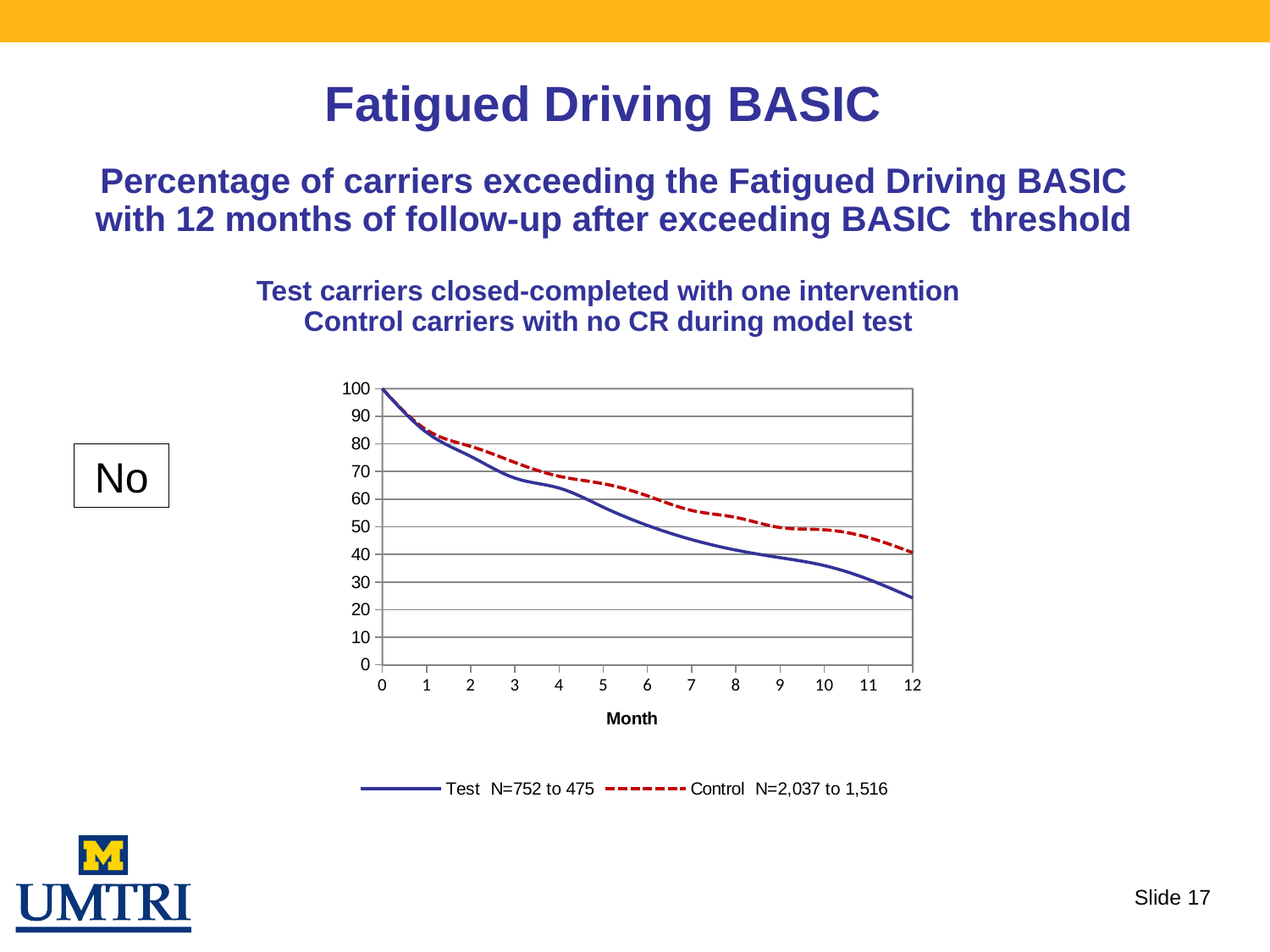
What is the value of the Control series at month 0? 100 How many series does the chart legend list? 2 Is the value for the Control series at month 12 greater or less than 30? greater Do the values of the Test series rise or fall as the month increases? fall Is the value for the Test series at month 6 greater or less than 60? less What is the value of the Test series at month 0? 100 At month 12, which series has the higher value, Test or Control? Control Is the value for the Test series at month 12 greater or less than 30? less What is the label of the x axis of the chart? Month Do the values of the Control series rise or fall as the month increases? fall What are the two series named in the chart legend? Test N=752 to 475 and Control N=2,037 to 1,516 What kind of chart is shown on the slide? line chart